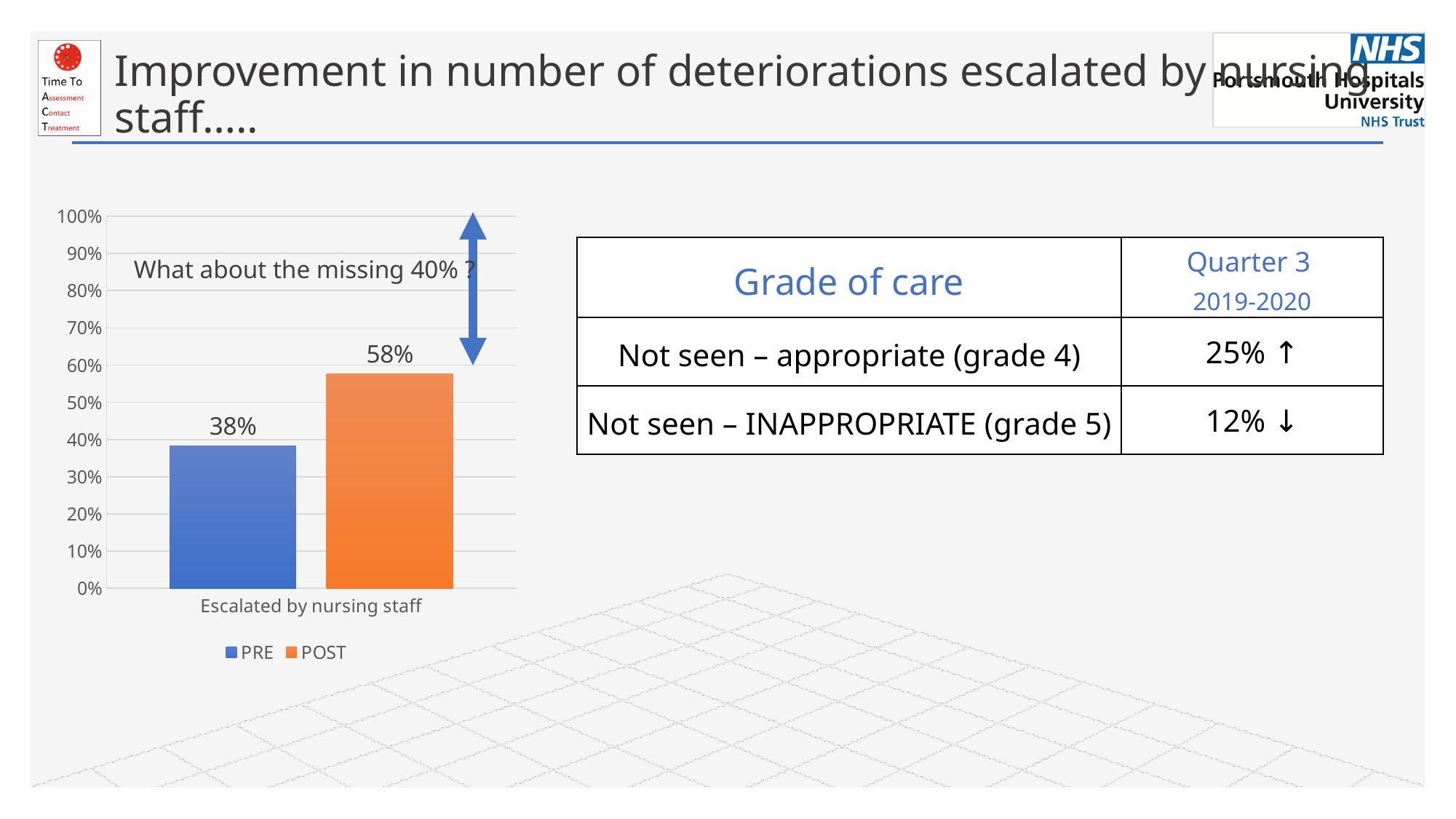
Which series has the highest value in the chart? POST Is the POST value greater or less than 50%? greater What is the POST value for Escalated by nursing staff? 58% How many series does the legend list? 2 Which series has the higher value for Escalated by nursing staff, PRE or POST? POST What colour is the POST bar? orange Which series has the lowest value in the chart? PRE What is the difference between the POST and PRE values for Escalated by nursing staff? 20% How many categories are shown on the x axis? 1 Is the PRE value greater or less than 40%? less What is the PRE value for Escalated by nursing staff? 38% What kind of chart is shown on the slide? bar chart